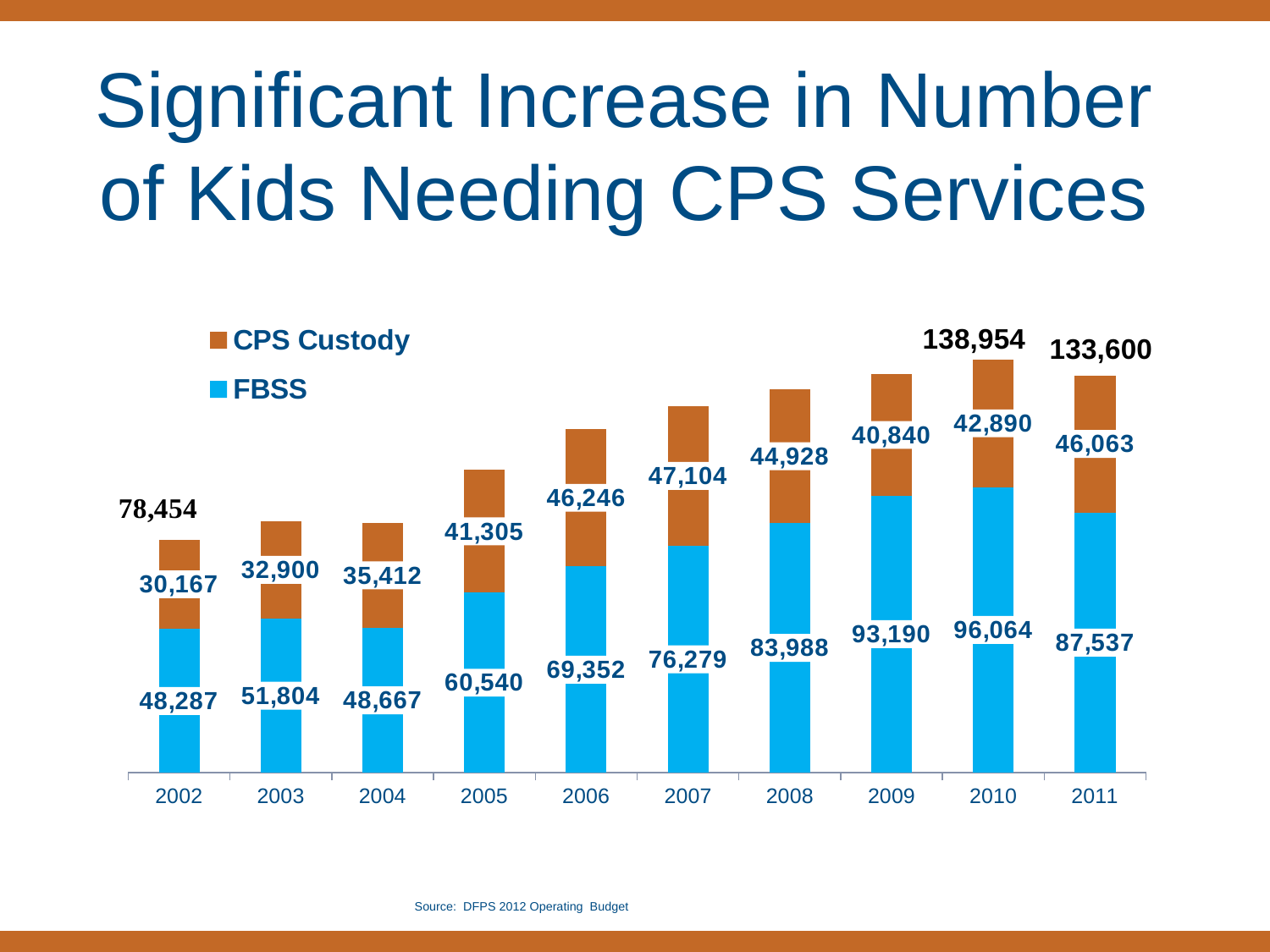
In which year is the CPS Custody value lowest? 2002 What kind of chart is shown on the slide? Stacked bar chart How many series does the legend list? 2 What is the difference between the FBSS values for 2010 and 2011? 8,527 What is the FBSS value for 2007? 76,279 In which year is the FBSS value highest? 2010 Which colour represents FBSS in the legend? Blue How many years are shown on the x axis? 10 Which year has the larger CPS Custody value, 2006 or 2008? 2006 What is the total of the stacked bar for 2009? 134,030 What is the CPS Custody value for 2005? 41,305 What is the total of the stacked bar for 2010? 138,954